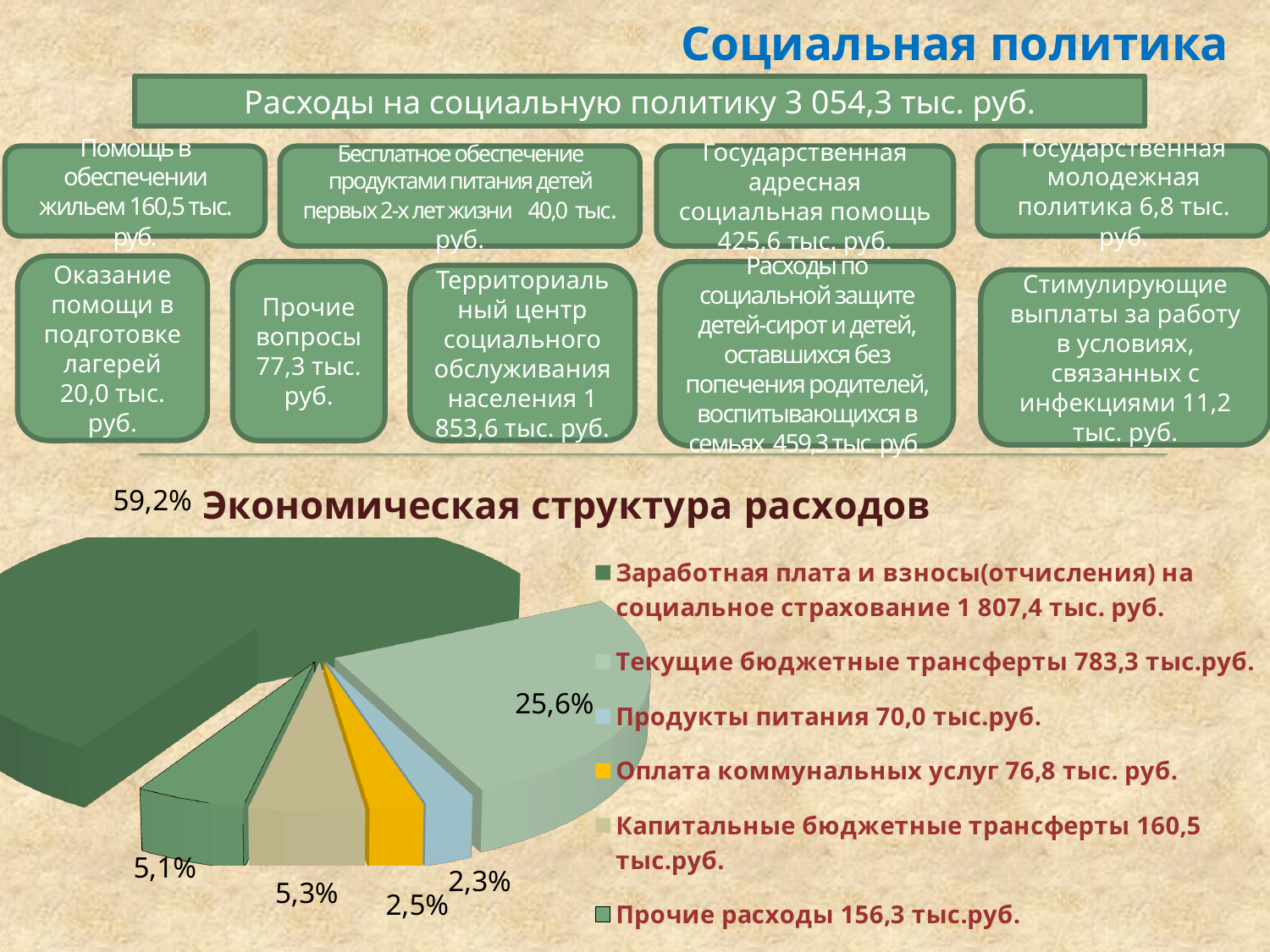
In the pie chart "Экономическая структура расходов", what percentage is shown for Текущие бюджетные трансферты? 25,6% Which category has the largest slice in the pie chart "Экономическая структура расходов"? Заработная плата и взносы(отчисления) на социальное страхование What kind of chart is shown under the heading "Экономическая структура расходов"? pie chart How many slices does the pie chart "Экономическая структура расходов" have? 6 Which category has the smallest slice in the pie chart "Экономическая структура расходов"? Продукты питания In the pie chart "Экономическая структура расходов", which is larger: Капитальные бюджетные трансферты or Прочие расходы? Капитальные бюджетные трансферты How many entries does the legend of the pie chart "Экономическая структура расходов" list? 6 In the pie chart "Экономическая структура расходов", what share is labelled for the largest slice (Заработная плата и взносы на социальное страхование)? 59,2% In the pie chart "Экономическая структура расходов", by how many percentage points does the 59,2% slice exceed the 25,6% slice? 33,6 What colour is the largest slice in the pie chart "Экономическая структура расходов"? dark green According to the legend of the pie chart "Экономическая структура расходов", what is the amount for Оплата коммунальных услуг? 76,8 тыс. руб. According to the legend of the pie chart "Экономическая структура расходов", what is the amount for Прочие расходы? 156,3 тыс.руб.